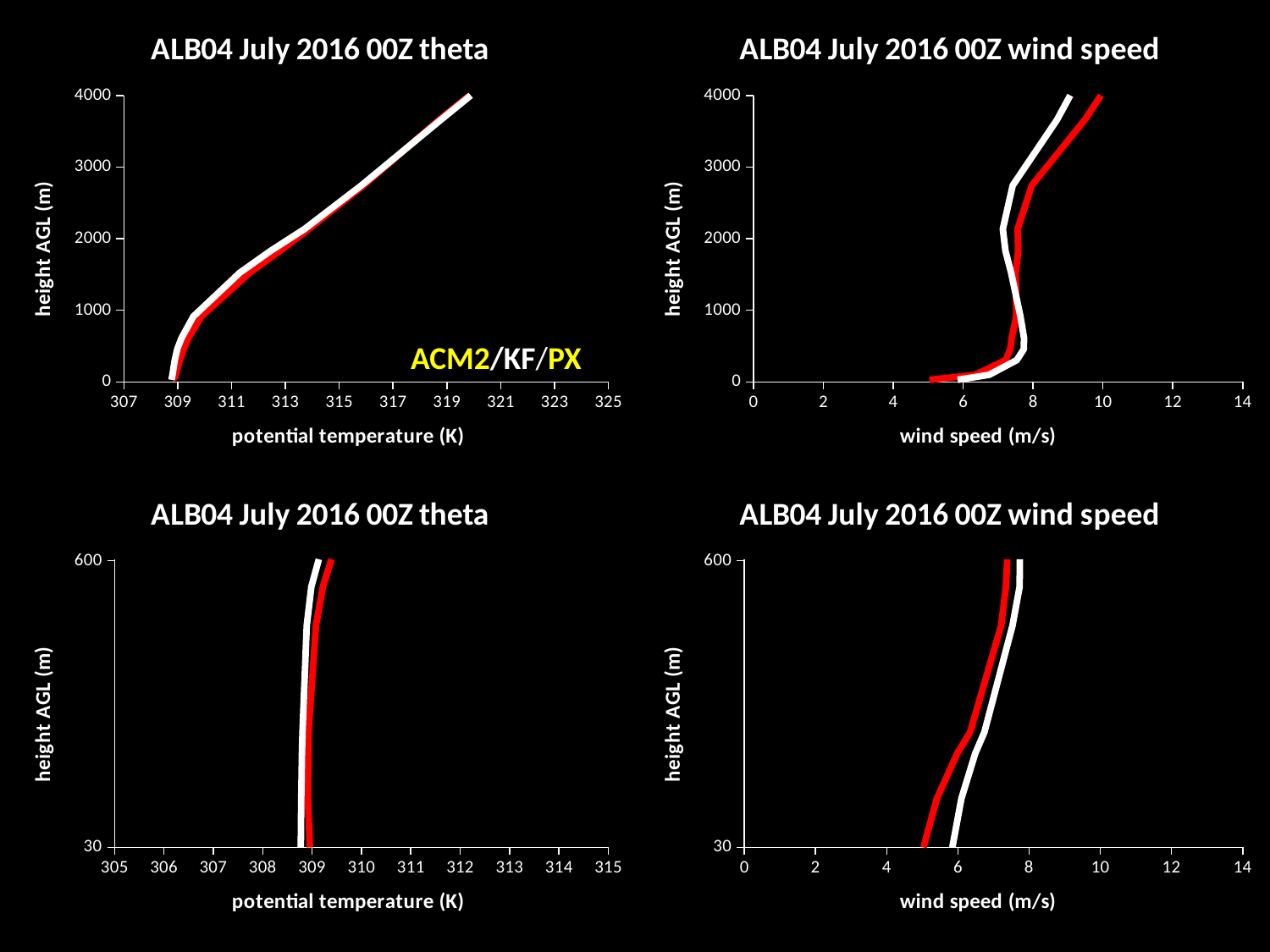
In the top-left 'ALB04 July 2016 00Z theta' chart, is the potential temperature at 4000 m greater or less than 317 K? greater In the bottom-right 'ALB04 July 2016 00Z wind speed' chart, is the red line's wind speed at 30 m greater or less than 6 m/s? less What kind of chart is the top-left 'ALB04 July 2016 00Z theta' chart? line chart What three model names are listed in the legend on the top-left chart? ACM2/KF/PX What is the x-axis label of the top-right 'ALB04 July 2016 00Z wind speed' chart? wind speed (m/s) In the bottom-right 'ALB04 July 2016 00Z wind speed' chart, does wind speed increase or decrease as height AGL increases from 30 m to 600 m? increase In the top-left 'ALB04 July 2016 00Z theta' chart, does potential temperature increase or decrease as height AGL increases? increase In the bottom-left 'ALB04 July 2016 00Z theta' chart, is the potential temperature at 600 m greater or less than 310 K? less In the top-right 'ALB04 July 2016 00Z wind speed' chart, at 4000 m, which line shows the higher wind speed, the red line or the white line? red line